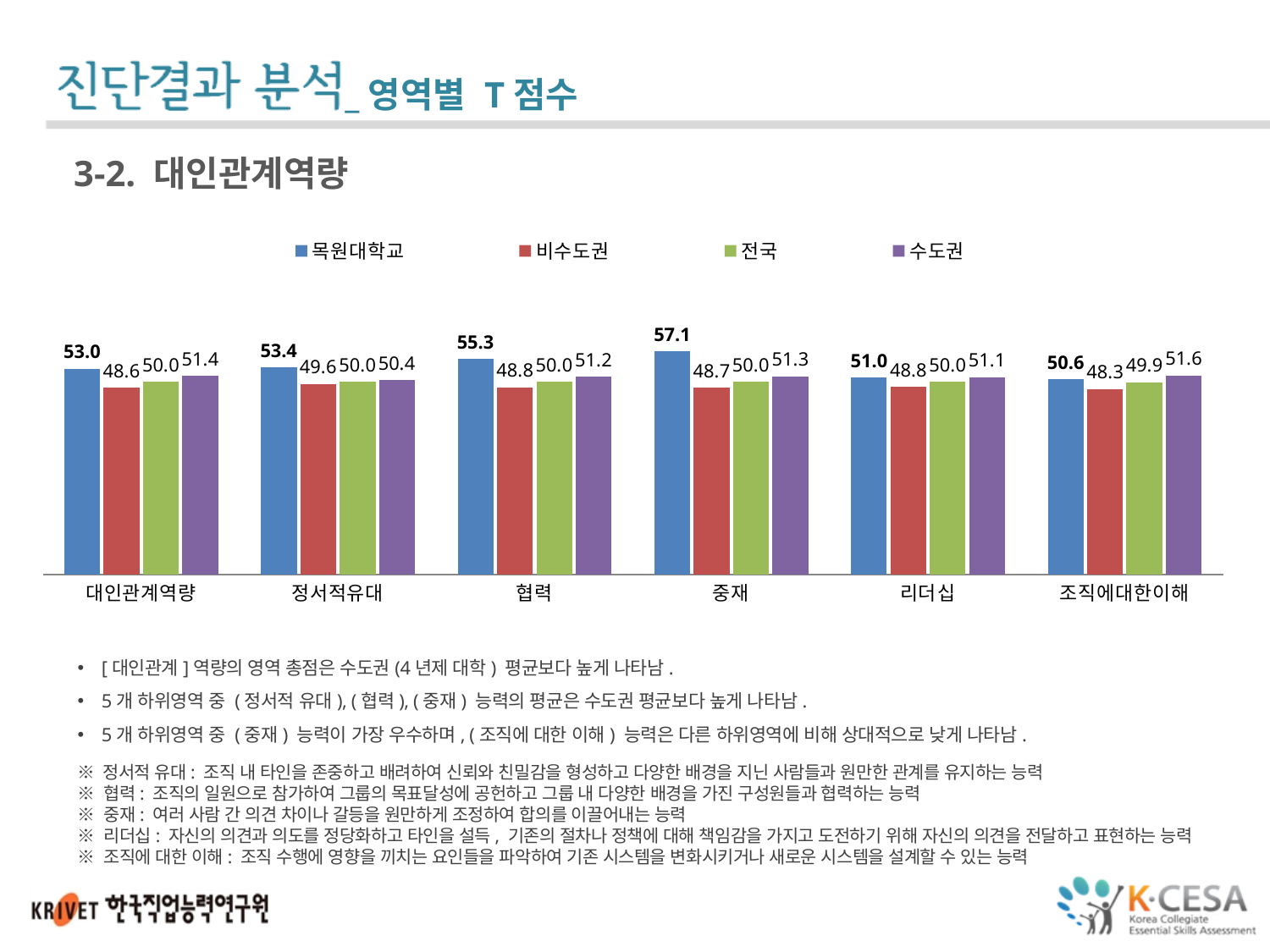
In which category does 목원대학교 have its lowest value? 조직에대한이해 What is the value for 목원대학교 in the 중재 category? 57.1 How many series does the legend list? 4 In which category does 목원대학교 have its highest value? 중재 What is the value for 수도권 in the 조직에대한이해 category? 51.6 What kind of chart is shown on the slide? Bar chart What is the value for 비수도권 in the 정서적유대 category? 49.6 Which is larger in the 리더십 category: the 목원대학교 value or the 수도권 value? 수도권 Which series is shown in green in the legend? 전국 What is the difference between the 목원대학교 value and the 수도권 value in the 협력 category? 4.1 How many categories are shown on the x axis of the chart? 6 Which is larger in the 대인관계역량 category: the 목원대학교 value or the 비수도권 value? 목원대학교